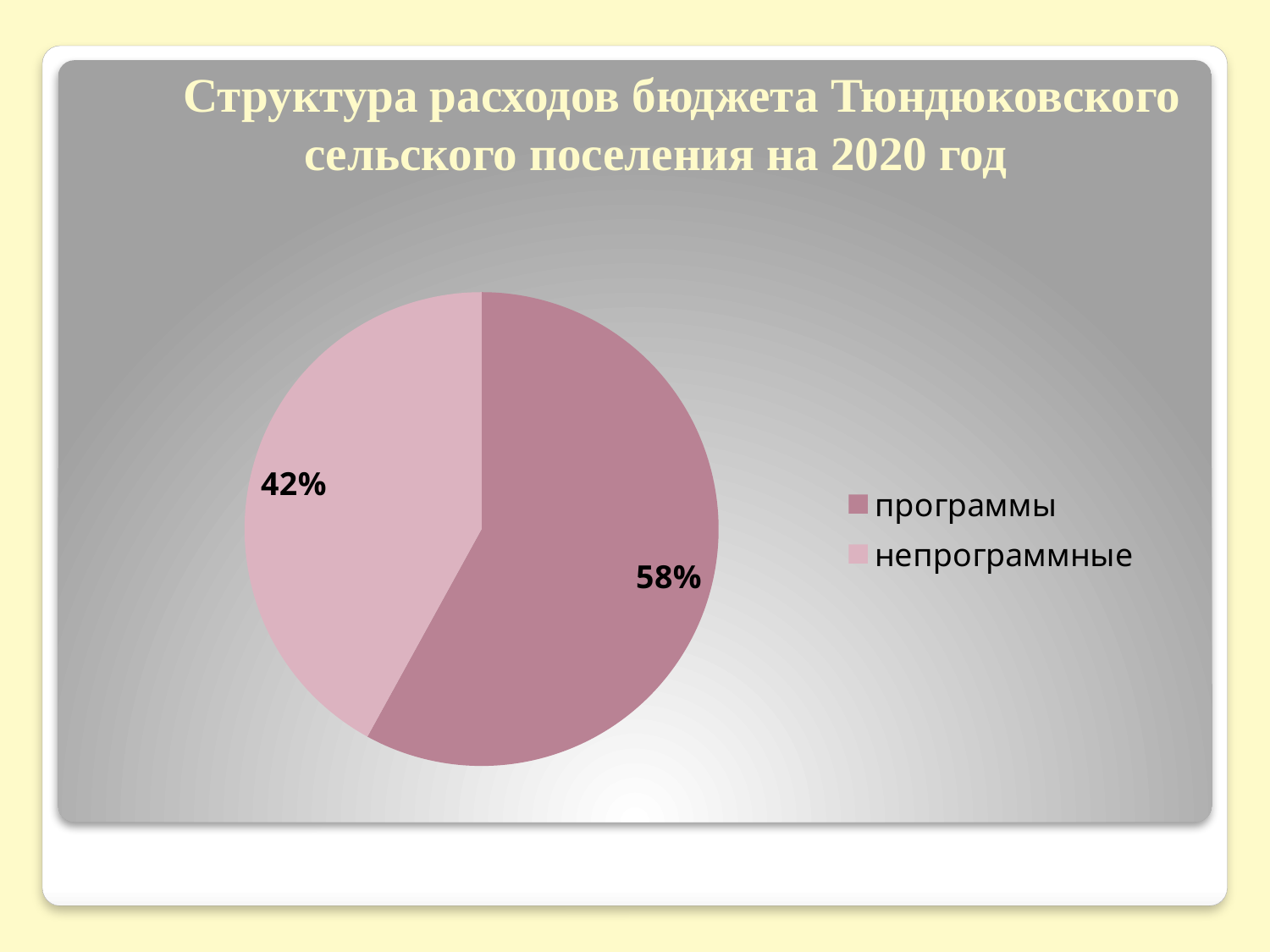
What kind of chart is shown on the slide? pie chart How many slices does the pie chart have? 2 Which category has the smallest slice of the pie? непрограммные What share of the pie does "непрограммные" take? 42% Which category has the largest slice of the pie? программы What is the title of the chart? Структура расходов бюджета Тюндюковского сельского поселения на 2020 год What share of the pie does "программы" take? 58% Which legend entry is shown in the lighter pink colour? непрограммные Which is larger, the "программы" slice or the "непрограммные" slice? программы What is the difference in percentage points between the "программы" and "непрограммные" slices? 16 How many entries does the legend list? 2 Is the share for "программы" greater or less than 50%? greater